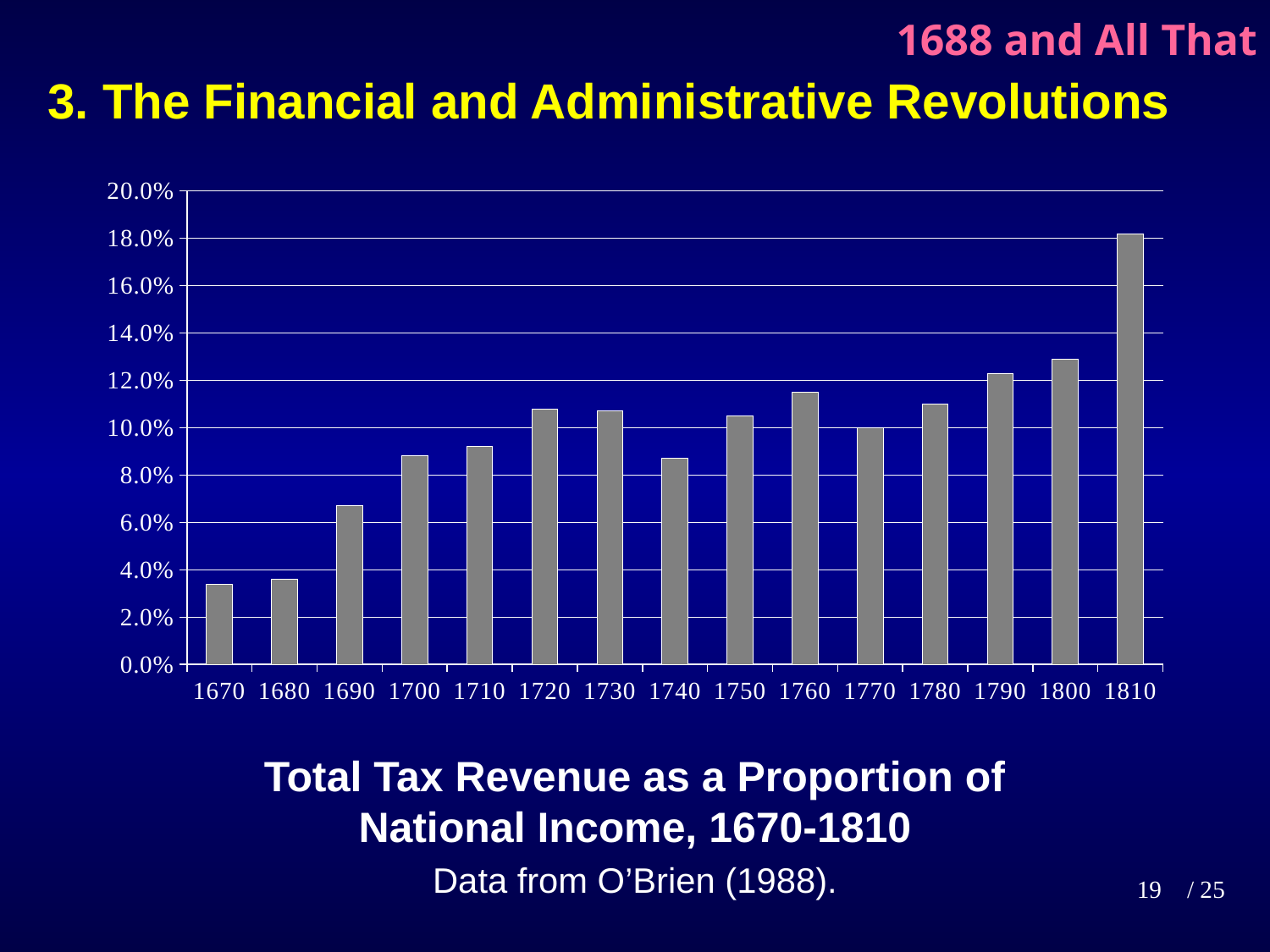
Is the value for 1800 greater or less than 12.0%? greater What is the title of the chart? Total Tax Revenue as a Proportion of National Income, 1670-1810 Is the value for 1810 greater or less than 16.0%? greater Is the value for 1670 greater or less than 4.0%? less Which year has the larger value, 1760 or 1740? 1760 Which year has the larger value, 1690 or 1700? 1700 How many years (bars) are plotted on the chart? 15 Overall, do the values rise or fall from 1670 to 1810? rise Which year has the highest total tax revenue as a proportion of national income? 1810 What kind of chart is shown on the slide? bar chart